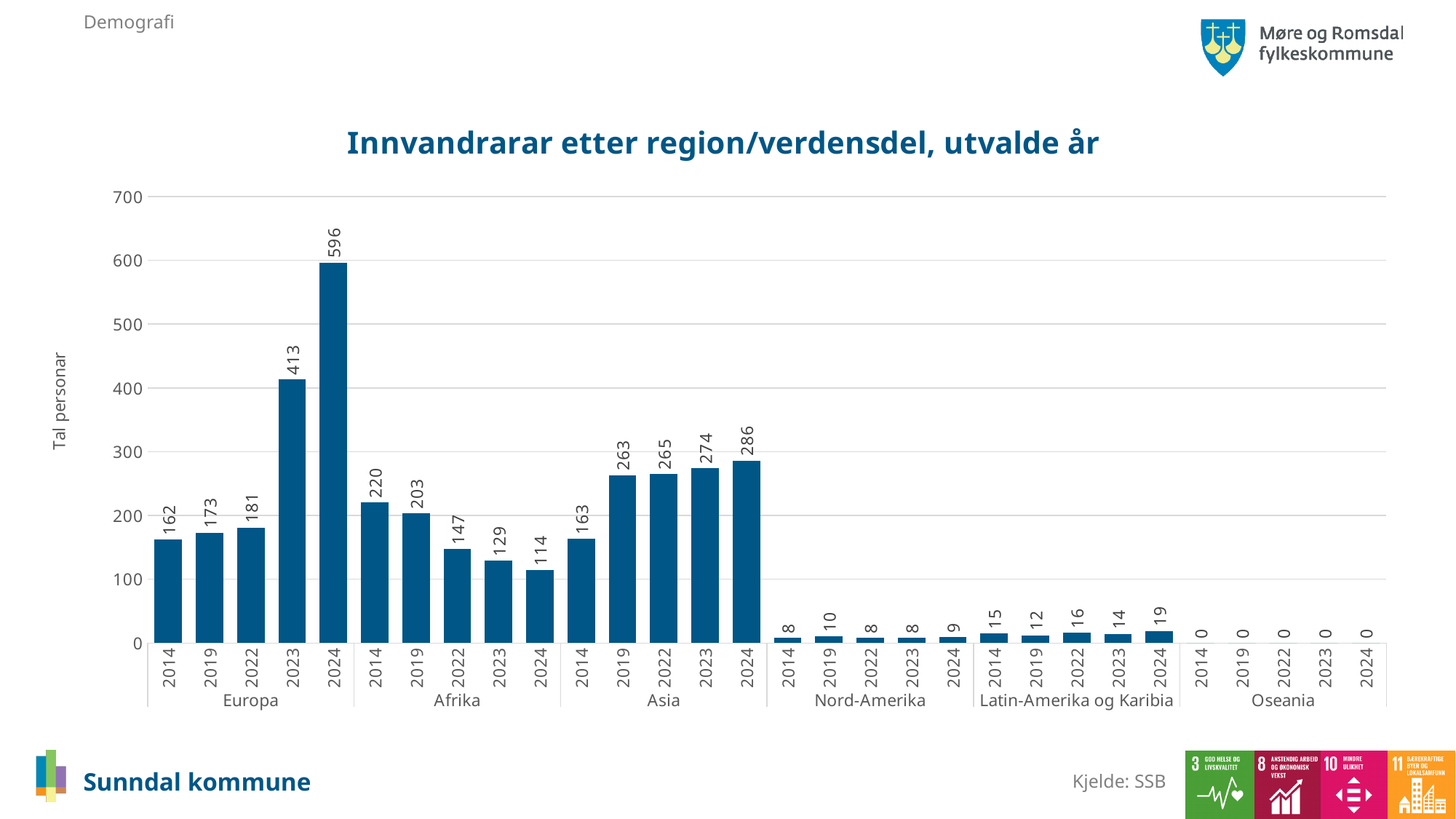
What is the value for Afrika in 2019? 203 Which region and year has the highest bar in the chart? Europa, 2024 Is the value for Europa in 2023 greater or less than 400? greater What is the difference between Europa in 2024 and Europa in 2023? 183 How many regions are shown on the x axis? 6 What is the value for Europa in 2024? 596 What is the difference between Afrika in 2014 and Afrika in 2024? 106 What is the value for Asia in 2023? 274 What kind of chart is shown on the slide? bar chart Do the values for Asia rise or fall from 2014 to 2024? rise What is the value for Latin-Amerika og Karibia in 2024? 19 Which is larger: Asia in 2014 or Afrika in 2014? Afrika in 2014